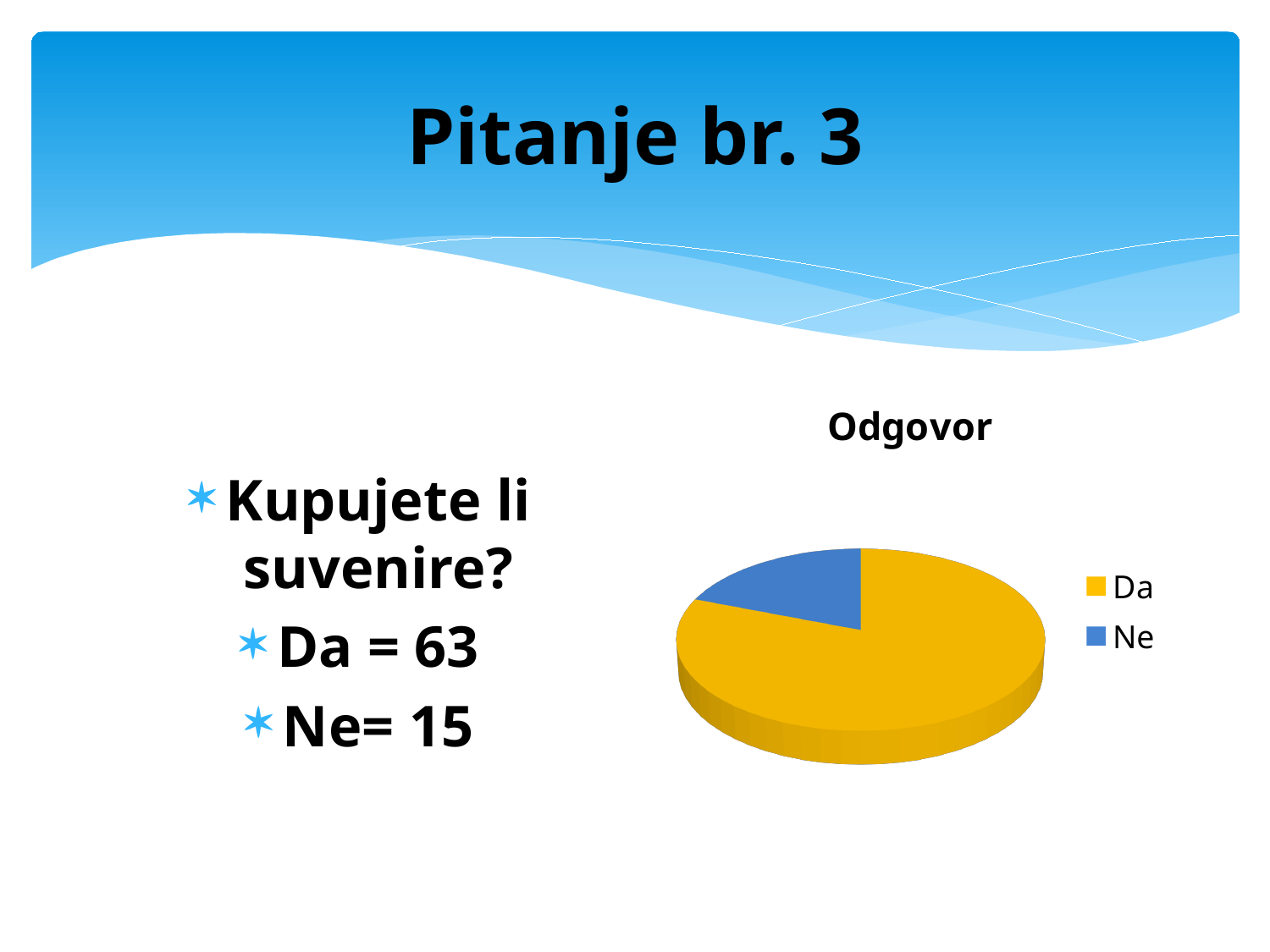
What is the value for Ne? 15 Which slice is larger, Da or Ne? Da What is the total of the values for Da and Ne? 78 What is the difference between the values for Da and Ne? 48 What kind of chart is shown on the slide? pie chart What is the value for Da? 63 What is the title of the chart? Odgovor How many entries does the chart legend list? 2 Which answer has the largest slice in the pie chart? Da How many slices does the pie chart have? 2 Which answer has the smallest slice in the pie chart? Ne What colour is the Da slice in the pie chart? yellow